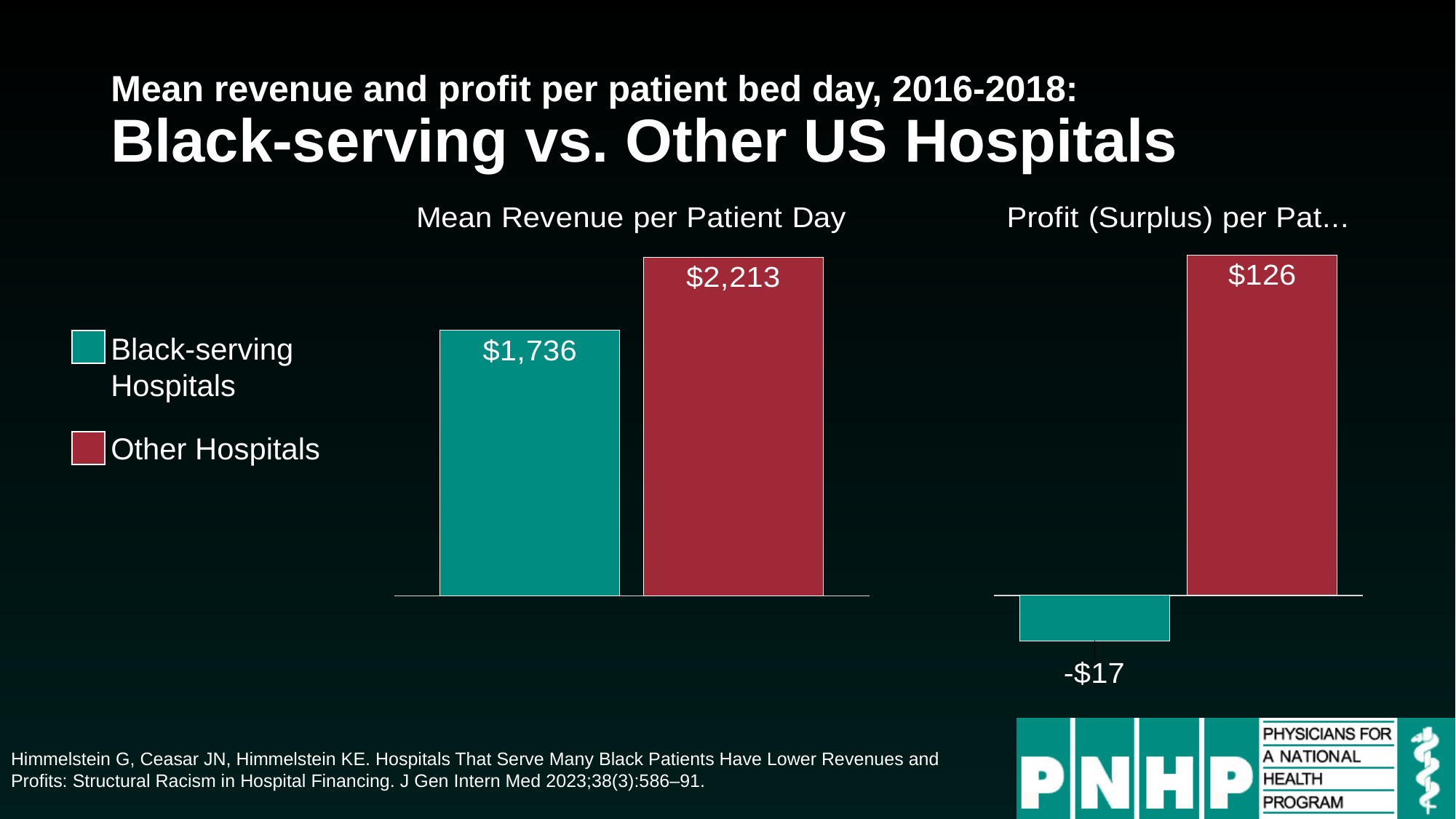
Which group has the higher mean revenue per patient day, Black-serving Hospitals or Other Hospitals? Other Hospitals What is the profit (surplus) per patient day for Other Hospitals? $126 What type of chart is shown on the slide? Bar chart What colour represents Black-serving Hospitals in the chart? Teal (green) What is the profit (surplus) per patient day for Black-serving Hospitals? -$17 What is the difference in profit (surplus) per patient day between Other Hospitals and Black-serving Hospitals? $143 How many series does the legend list? 2 Which bar shows the highest value on the chart? Other Hospitals, Mean Revenue per Patient Day ($2,213) Which group has the lower profit (surplus) per patient day? Black-serving Hospitals What is the mean revenue per patient day for Black-serving Hospitals? $1,736 What is the difference in mean revenue per patient day between Other Hospitals and Black-serving Hospitals? $477 What is the mean revenue per patient day for Other Hospitals? $2,213